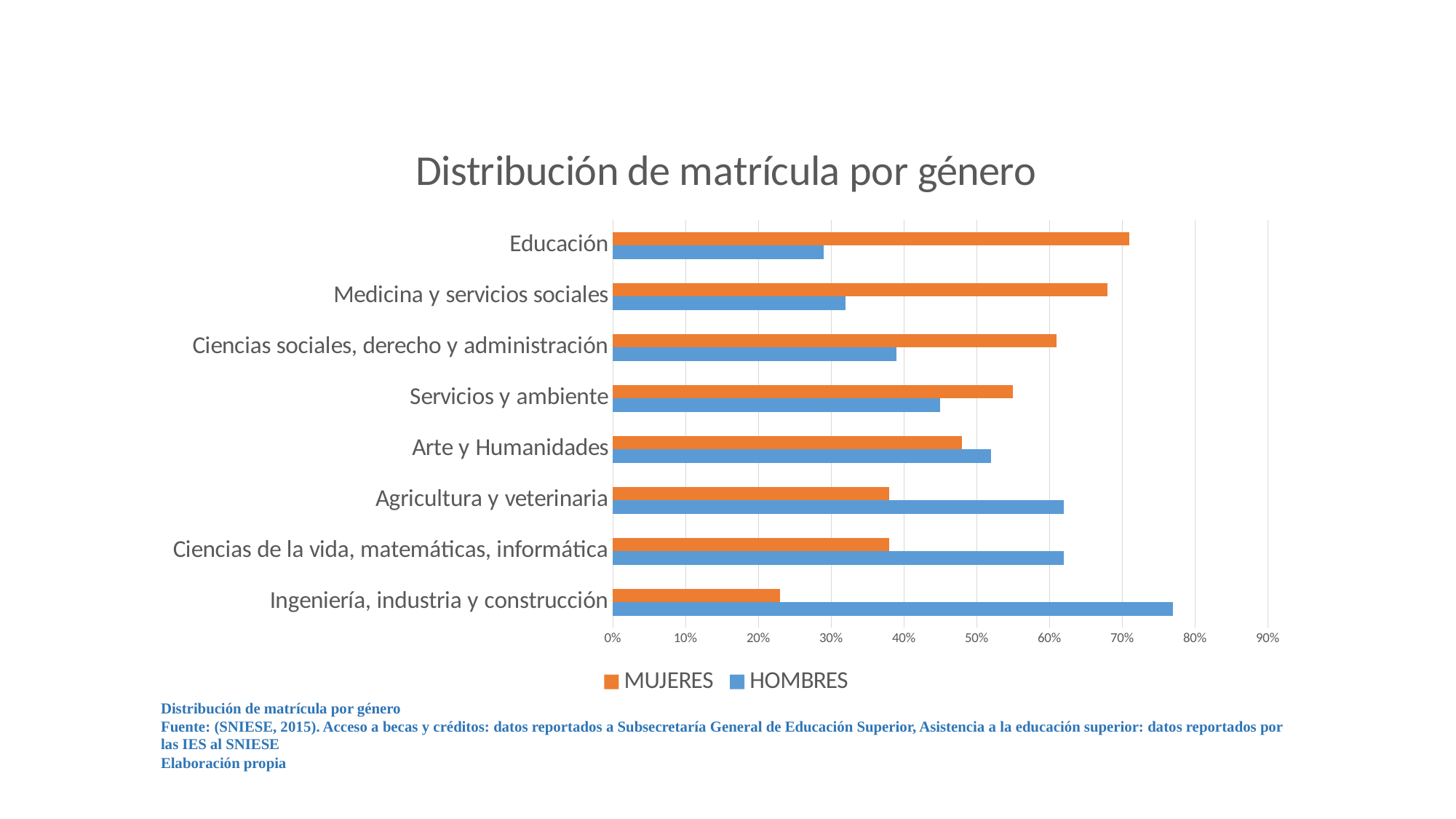
Is the HOMBRES value for Ingeniería, industria y construcción greater or less than 70%? greater What is the title of the chart? Distribución de matrícula por género Which category has the highest value for HOMBRES? Ingeniería, industria y construcción Which colour represents the MUJERES series in the legend? orange Is the MUJERES value for Servicios y ambiente greater or less than 50%? greater What type of chart is shown on the slide? bar chart How many categories (fields of study) are shown on the chart? 8 Which category has the highest value for MUJERES? Educación For Arte y Humanidades, which series has the larger value, MUJERES or HOMBRES? HOMBRES How many series does the legend list? 2 Which category has the lowest value for HOMBRES? Educación Which category has the lowest value for MUJERES? Ingeniería, industria y construcción